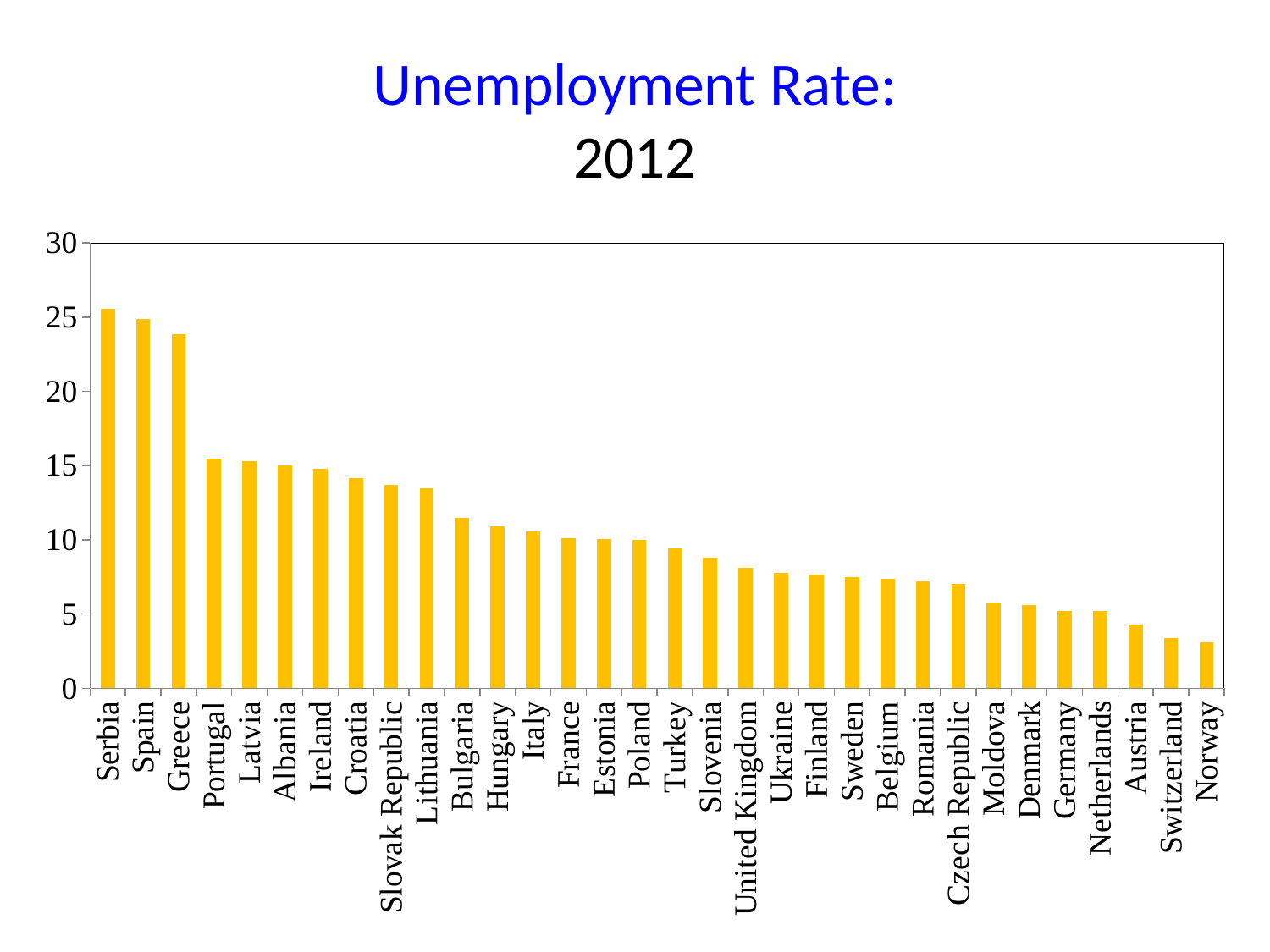
Is the value for Greece greater or less than 20? greater Is the value for Croatia greater or less than 15? less Which has the higher unemployment rate, Greece or Portugal? Greece Which country has the highest unemployment rate in the chart? Serbia What is the title of the chart? Unemployment Rate: 2012 Do the values rise or fall moving from left to right along the x axis? fall Which country has the lowest unemployment rate in the chart? Norway What kind of chart is shown on the slide? bar chart How many countries are shown in the chart? 32 Is the value for Austria greater or less than 5? less